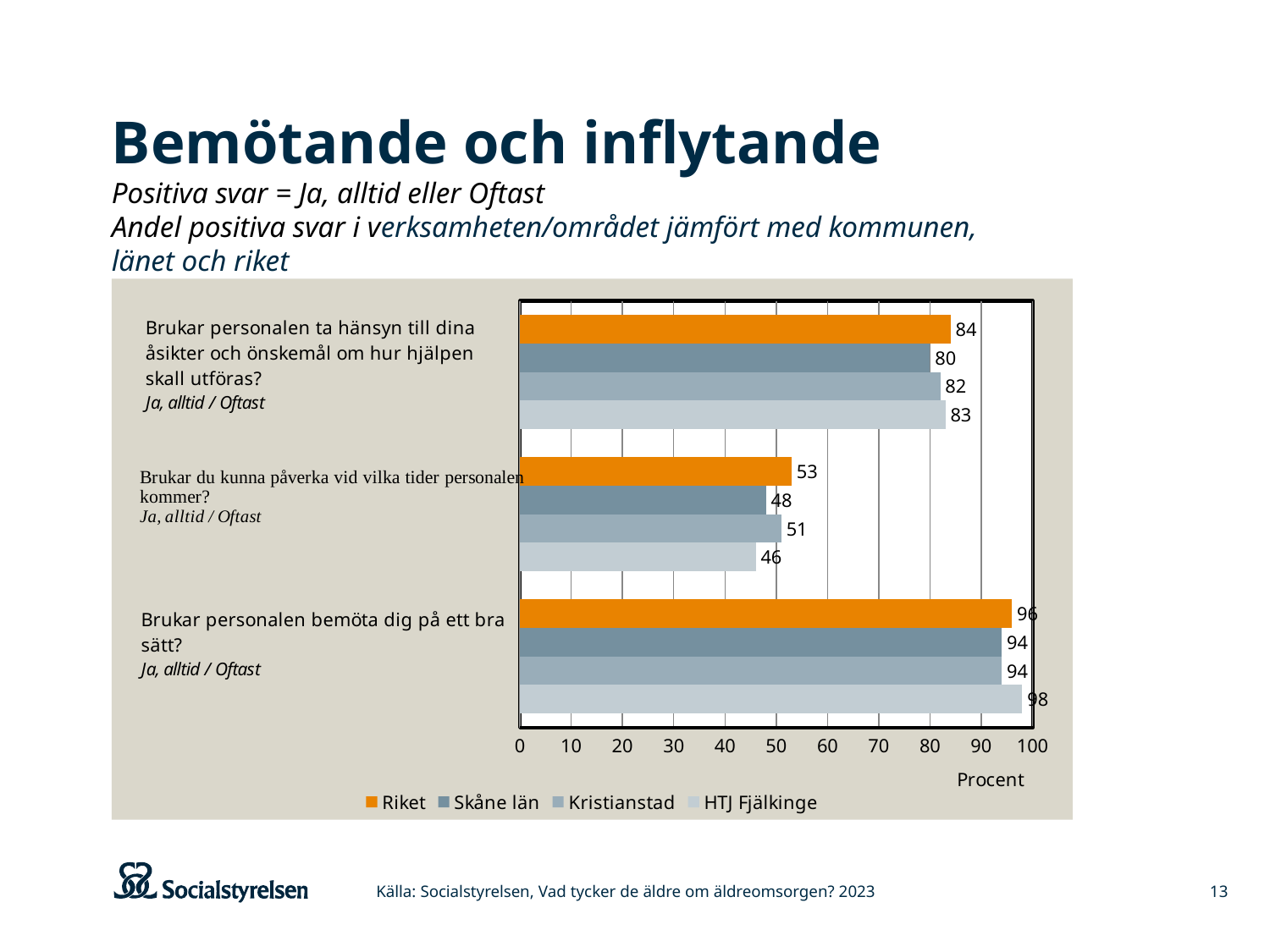
How many series does the legend list? 4 What is the value for Riket on the question "Brukar personalen ta hänsyn till dina åsikter och önskemål om hur hjälpen skall utföras?"? 84 What unit label is shown on the horizontal axis of the chart? Procent Which series has the lowest value on the question "Brukar du kunna påverka vid vilka tider personalen kommer?"? HTJ Fjälkinge Which series has the highest value on the question "Brukar personalen bemöta dig på ett bra sätt?"? HTJ Fjälkinge Is the value for Riket on the question "Brukar du kunna påverka vid vilka tider personalen kommer?" greater or less than 50? greater What is the value for Skåne län on the question "Brukar personalen bemöta dig på ett bra sätt?"? 94 On the question "Brukar personalen ta hänsyn till dina åsikter och önskemål om hur hjälpen skall utföras?", which is larger: the value for Kristianstad or the value for Skåne län? Kristianstad How many question categories are shown in the chart? 3 What is the value for HTJ Fjälkinge on the question "Brukar du kunna påverka vid vilka tider personalen kommer?"? 46 What is the difference between the Riket value and the Skåne län value on the question "Brukar du kunna påverka vid vilka tider personalen kommer?"? 5 What kind of chart is shown on the slide? Bar chart